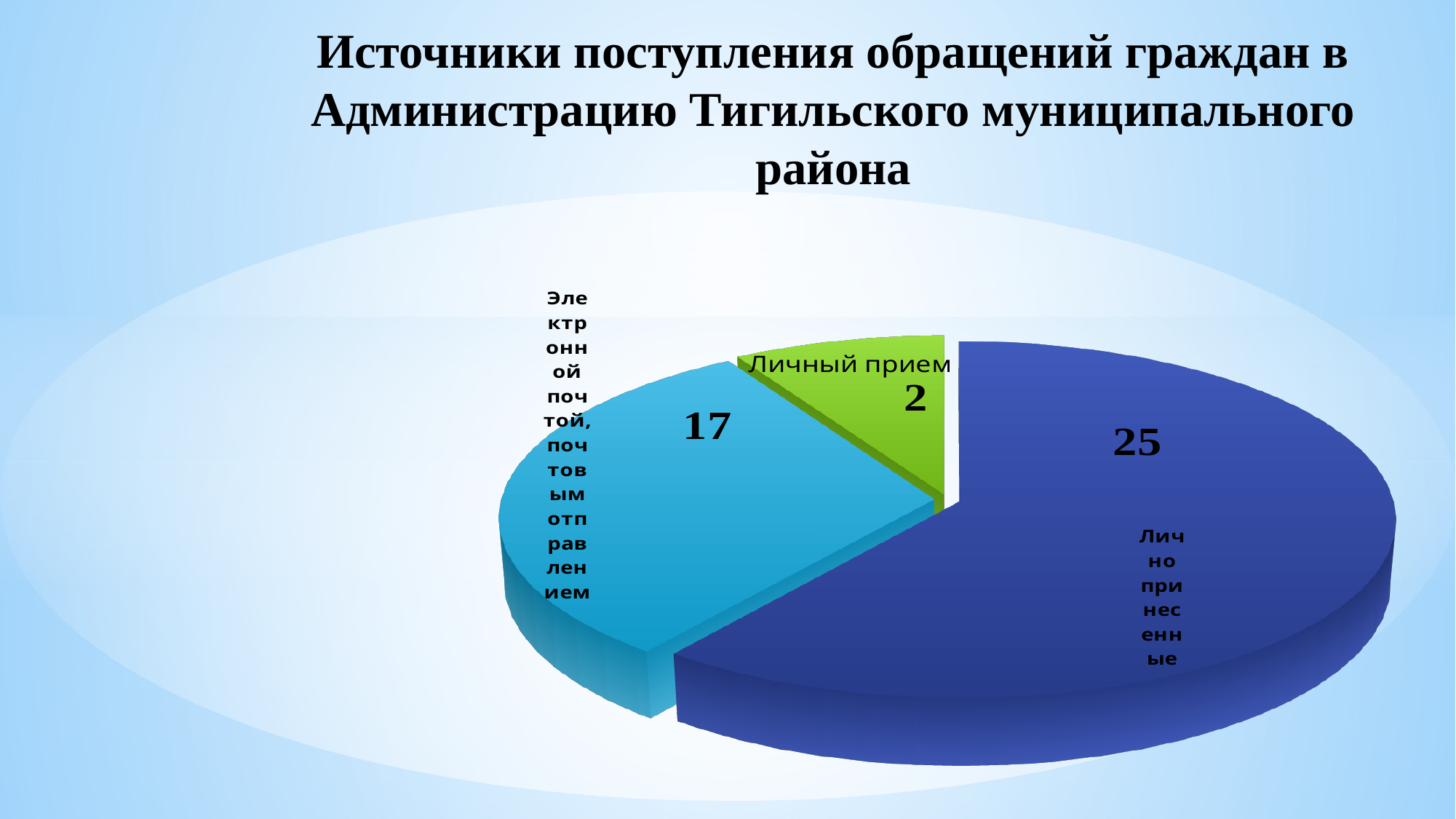
What is the difference between the values for "Электронной почтой, почтовым отправлением" and "Личный прием"? 15 How many slices does the pie chart have? 3 Which is larger: the value for "Лично принесенные" or the value for "Личный прием"? Лично принесенные What type of chart is shown on the slide? Pie chart What is the value for "Электронной почтой, почтовым отправлением"? 17 What is the value for "Лично принесенные"? 25 What is the difference between the values for "Лично принесенные" and "Электронной почтой, почтовым отправлением"? 8 What is the total of all slices in the pie chart? 44 Which source has the largest slice of the pie? Лично принесенные What is the title of the chart on the slide? Источники поступления обращений граждан в Администрацию Тигильского муниципального района Which source has the smallest slice of the pie? Личный прием What is the value for "Личный прием"? 2